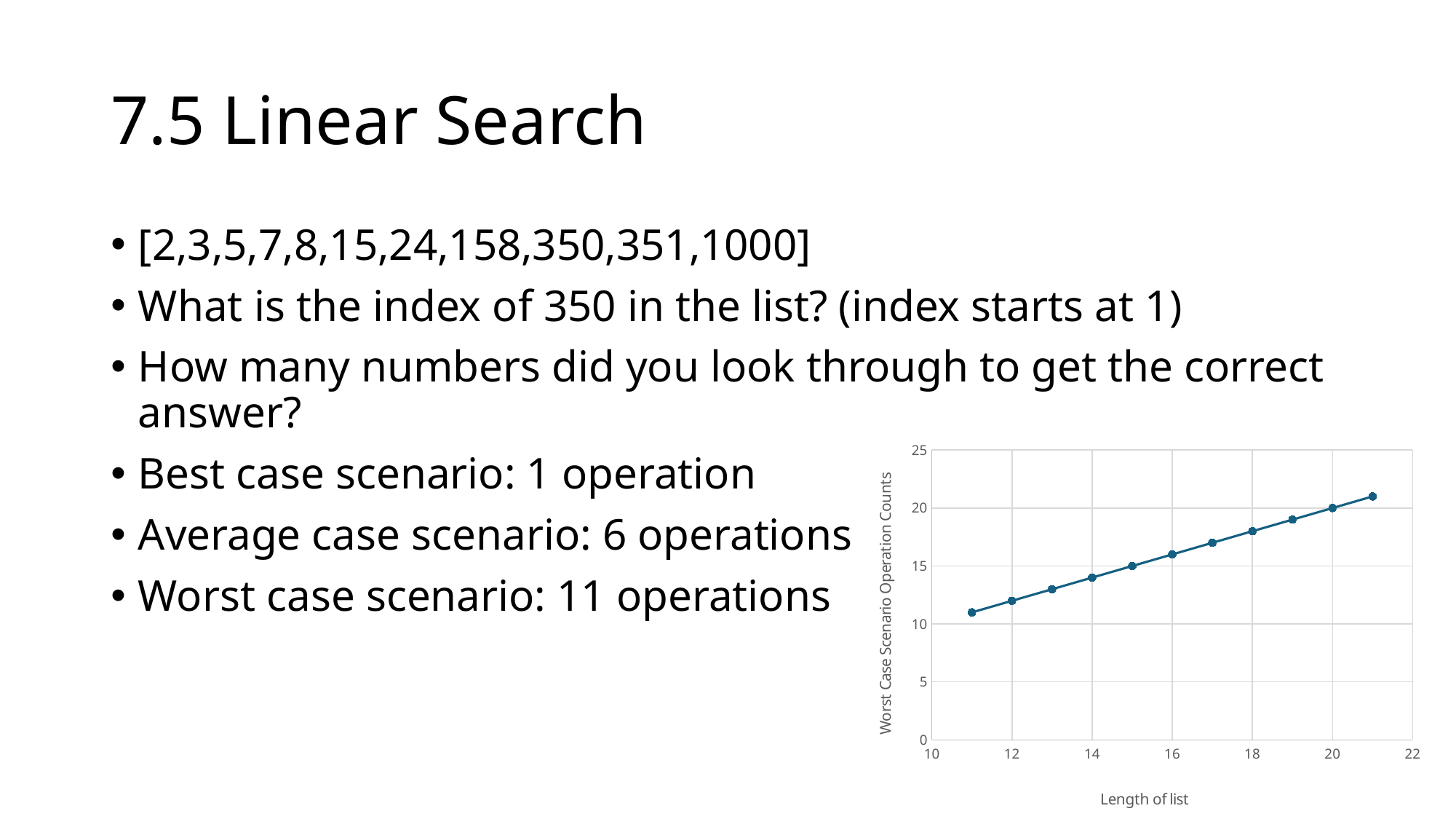
Is the worst case operation count for a list of length 21 greater or less than 20? greater How many data points are plotted on the chart? 11 Do the worst case operation counts rise or fall as the length of list increases? rise What is the worst case operation count when the length of list is 20? 20 What is the title of the x axis of the chart? Length of list What is the worst case operation count when the length of list is 15? 15 What is the title of the y axis of the chart? Worst Case Scenario Operation Counts Is the worst case operation count for a list of length 12 greater or less than 15? less What kind of chart is shown on the slide? line chart At which length of list is the worst case operation count lowest? 11 At which length of list is the worst case operation count highest? 21 Which has a larger worst case operation count: a list of length 13 or a list of length 19? a list of length 19